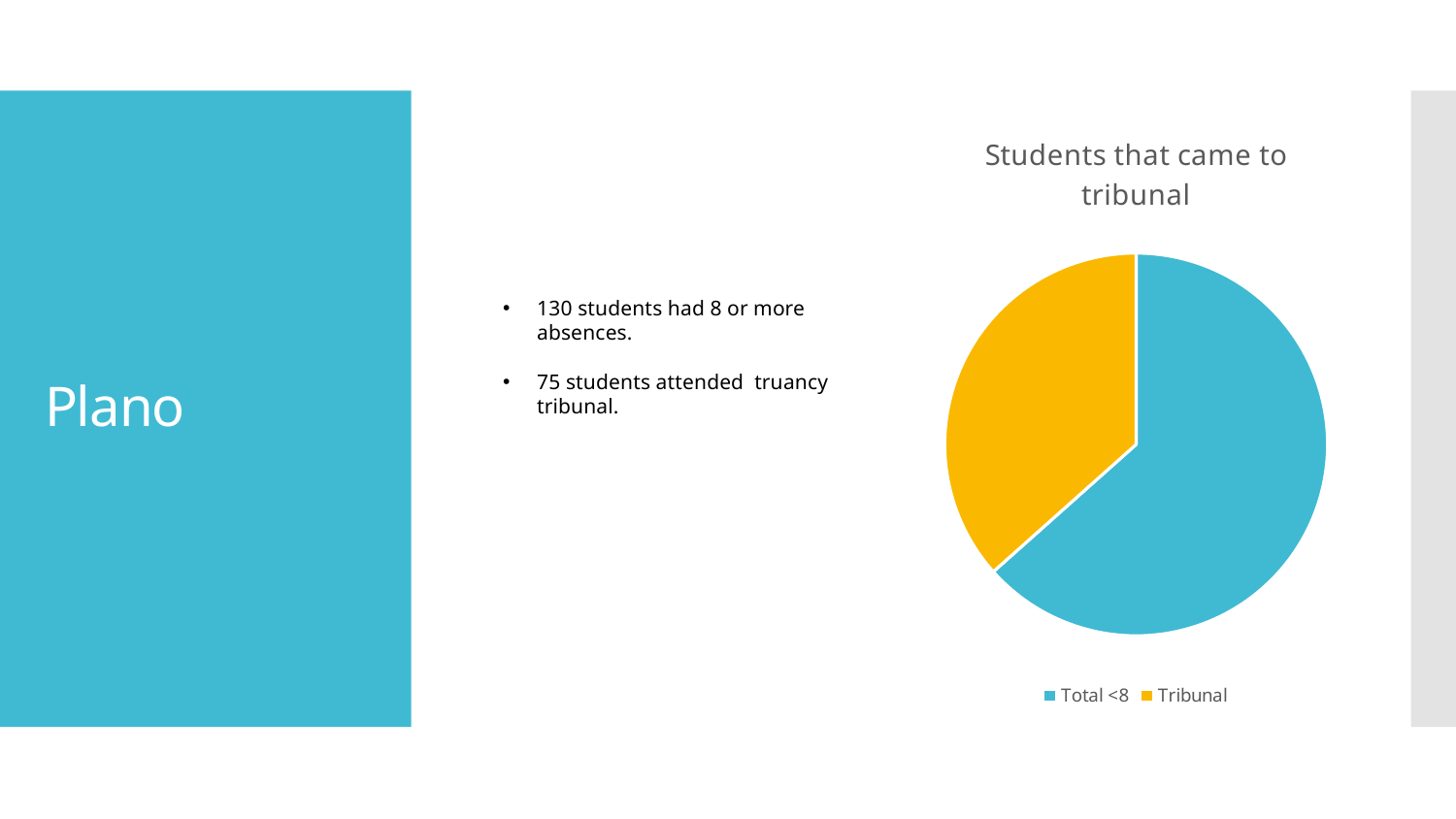
Does the Tribunal slice take up more or less than half of the pie? less How many entries does the chart legend list? 2 What kind of chart is shown on the slide? pie chart Which slice of the pie chart is the largest? Total <8 Which slice is larger, Total <8 or Tribunal? Total <8 Which slice of the pie chart is the smallest? Tribunal What colour is the Tribunal slice in the pie chart? yellow Does the Total <8 slice take up more or less than half of the pie? more How many slices does the pie chart have? 2 What is the title of the chart? Students that came to tribunal